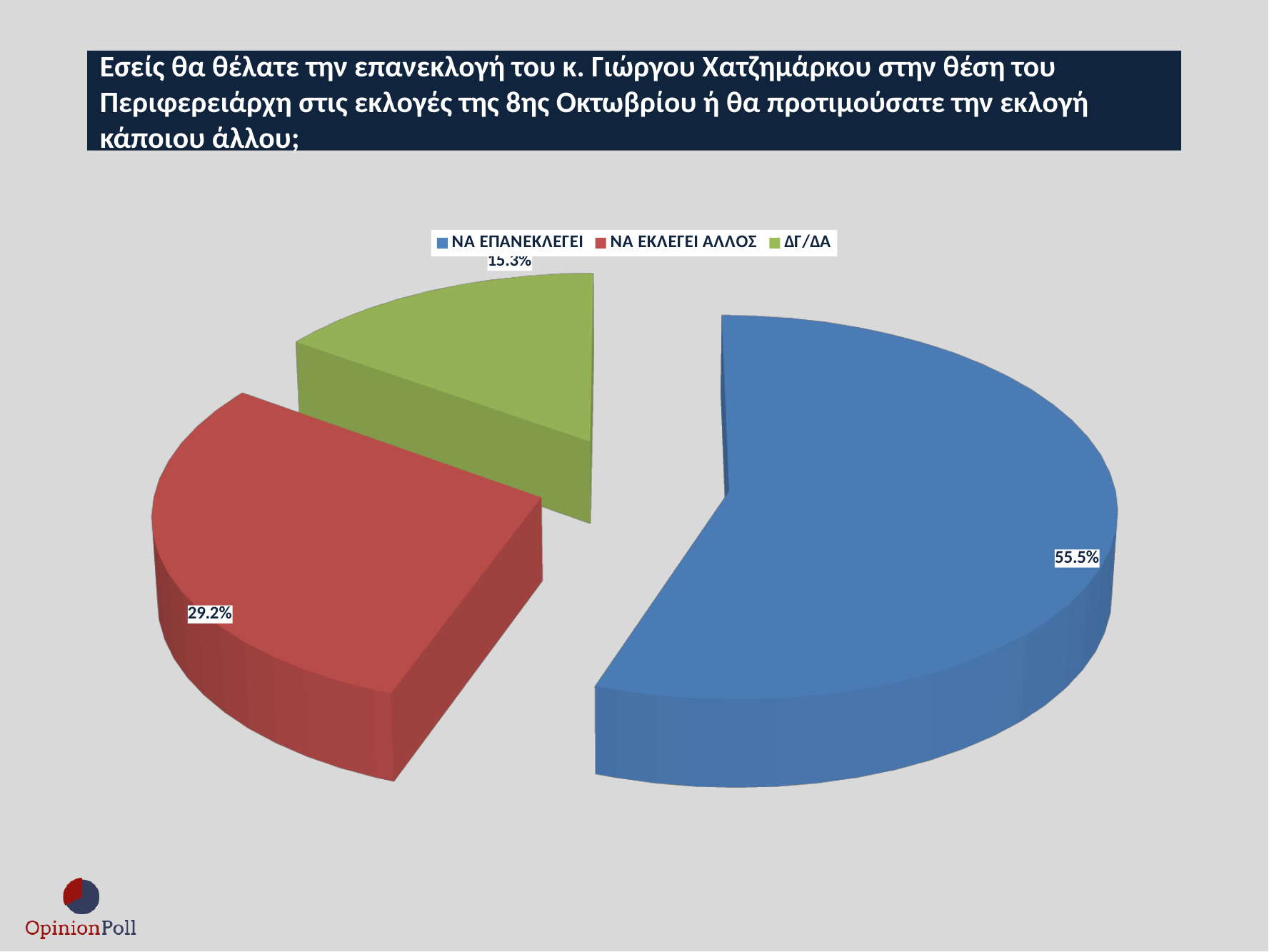
Which response has the largest share of the pie? ΝΑ ΕΠΑΝΕΚΛΕΓΕΙ Which response is shown in green in the legend? ΔΓ/ΔΑ Which response has the smallest share of the pie? ΔΓ/ΔΑ What percentage of respondents chose ΝΑ ΕΠΑΝΕΚΛΕΓΕΙ? 55.5% How many slices does the pie chart have? 3 What percentage of respondents chose ΝΑ ΕΚΛΕΓΕΙ ΑΛΛΟΣ? 29.2% What percentage of respondents answered ΔΓ/ΔΑ? 15.3% Which is larger, the share for ΝΑ ΕΚΛΕΓΕΙ ΑΛΛΟΣ or the share for ΔΓ/ΔΑ? ΝΑ ΕΚΛΕΓΕΙ ΑΛΛΟΣ What is the difference in percentage points between ΝΑ ΕΚΛΕΓΕΙ ΑΛΛΟΣ and ΔΓ/ΔΑ? 13.9 What colour is the slice for ΝΑ ΕΠΑΝΕΚΛΕΓΕΙ? Blue What is the difference in percentage points between ΝΑ ΕΠΑΝΕΚΛΕΓΕΙ and ΝΑ ΕΚΛΕΓΕΙ ΑΛΛΟΣ? 26.3 What kind of chart is shown on the slide? Pie chart